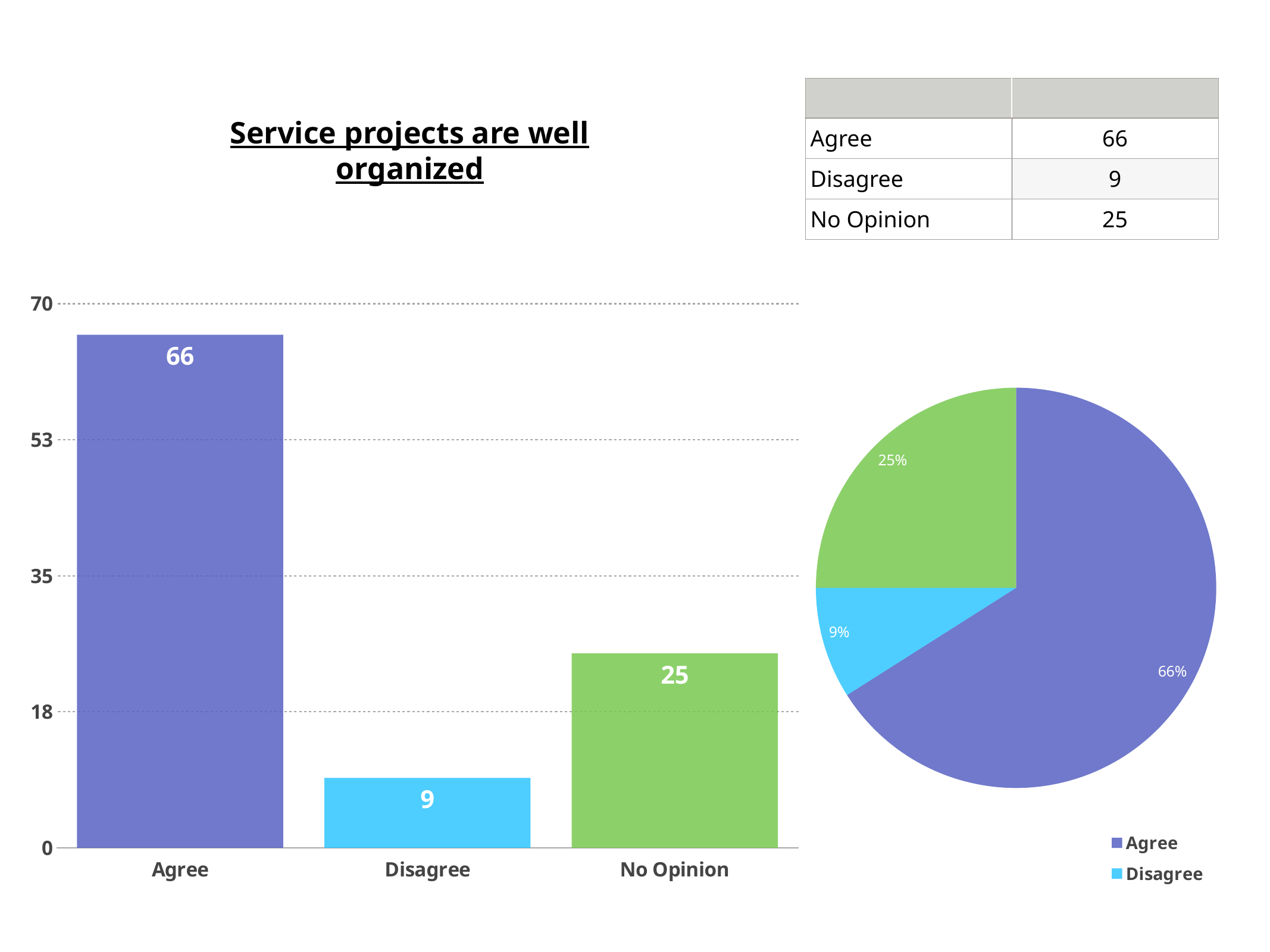
In the bar chart on the left, which is larger, the value for No Opinion or the value for Disagree? No Opinion In the pie chart on the right, what share does the Disagree slice have? 9% In the bar chart on the left, which category has the highest value? Agree What kind of chart is the chart on the right of the slide? Pie chart In the pie chart on the right, what share does the Agree slice have? 66% In the bar chart on the left, what is the value for No Opinion? 25 What kind of chart is the chart on the left of the slide? Bar chart In the bar chart on the left, what is the value for Agree? 66 In the bar chart on the left, what is the value for Disagree? 9 In the bar chart on the left, what is the difference between the values for Agree and No Opinion? 41 In the bar chart on the left, which category has the lowest value? Disagree In the bar chart on the left, how many categories are shown on the x axis? 3